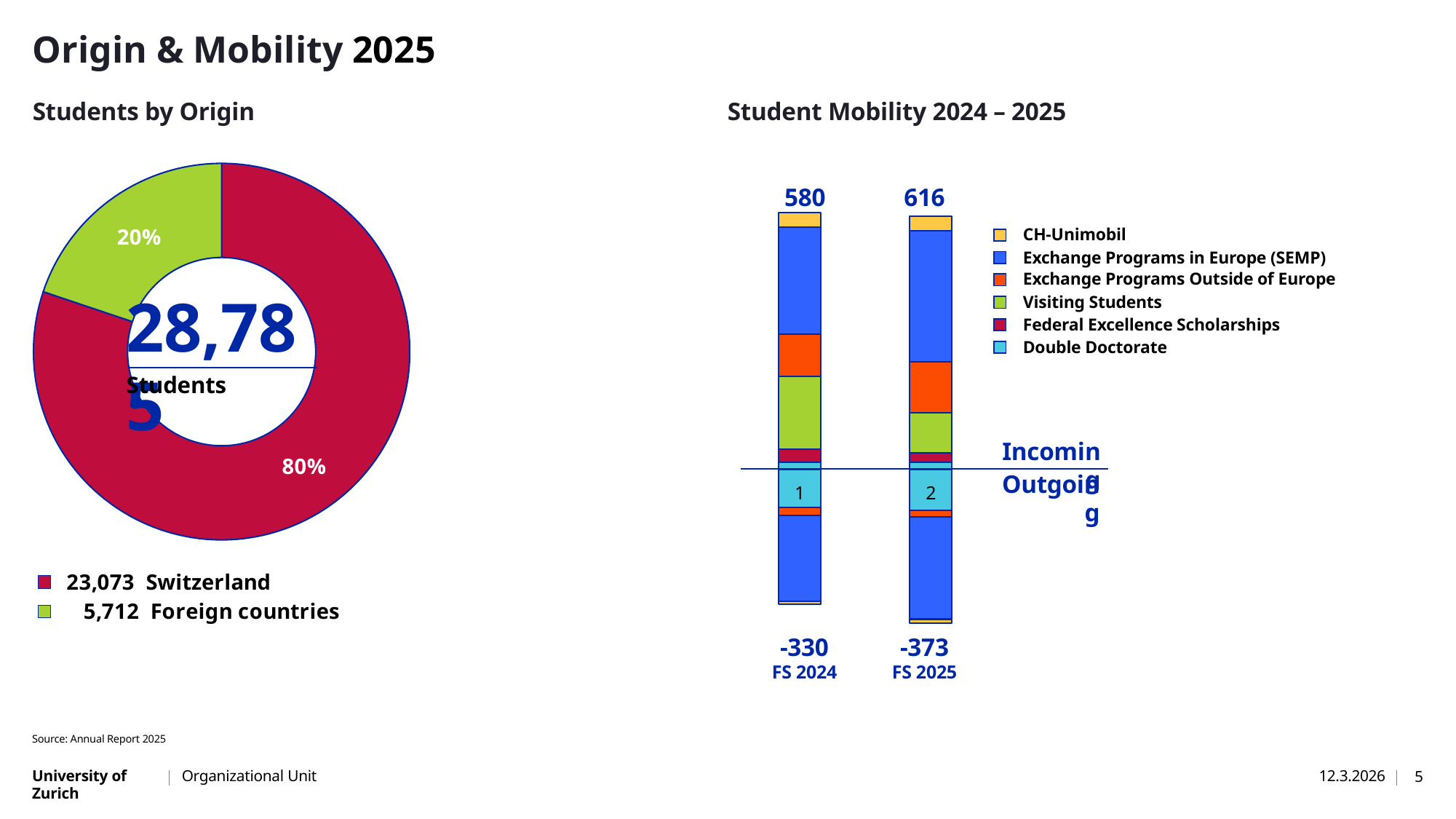
What kind of chart is the Student Mobility 2024 – 2025 chart? Stacked bar chart In the Students by Origin chart, how many students are from Switzerland? 23,073 In the Student Mobility 2024 – 2025 chart, what is the outgoing total for FS 2025? -373 In the Students by Origin chart, how many students are from foreign countries? 5,712 In the Students by Origin chart, what share of students come from Switzerland? 80% How many series does the legend of the Student Mobility 2024 – 2025 chart list? 6 In the Student Mobility 2024 – 2025 chart, by how much did the incoming total increase from FS 2024 to FS 2025? 36 In the Student Mobility 2024 – 2025 chart, what is the incoming total for FS 2025? 616 In the Student Mobility 2024 – 2025 chart, what is the incoming total for FS 2024? 580 In the Students by Origin chart, what share of students come from foreign countries? 20% What kind of chart is the Students by Origin chart? Pie (donut) chart How many categories does the Students by Origin chart show? 2